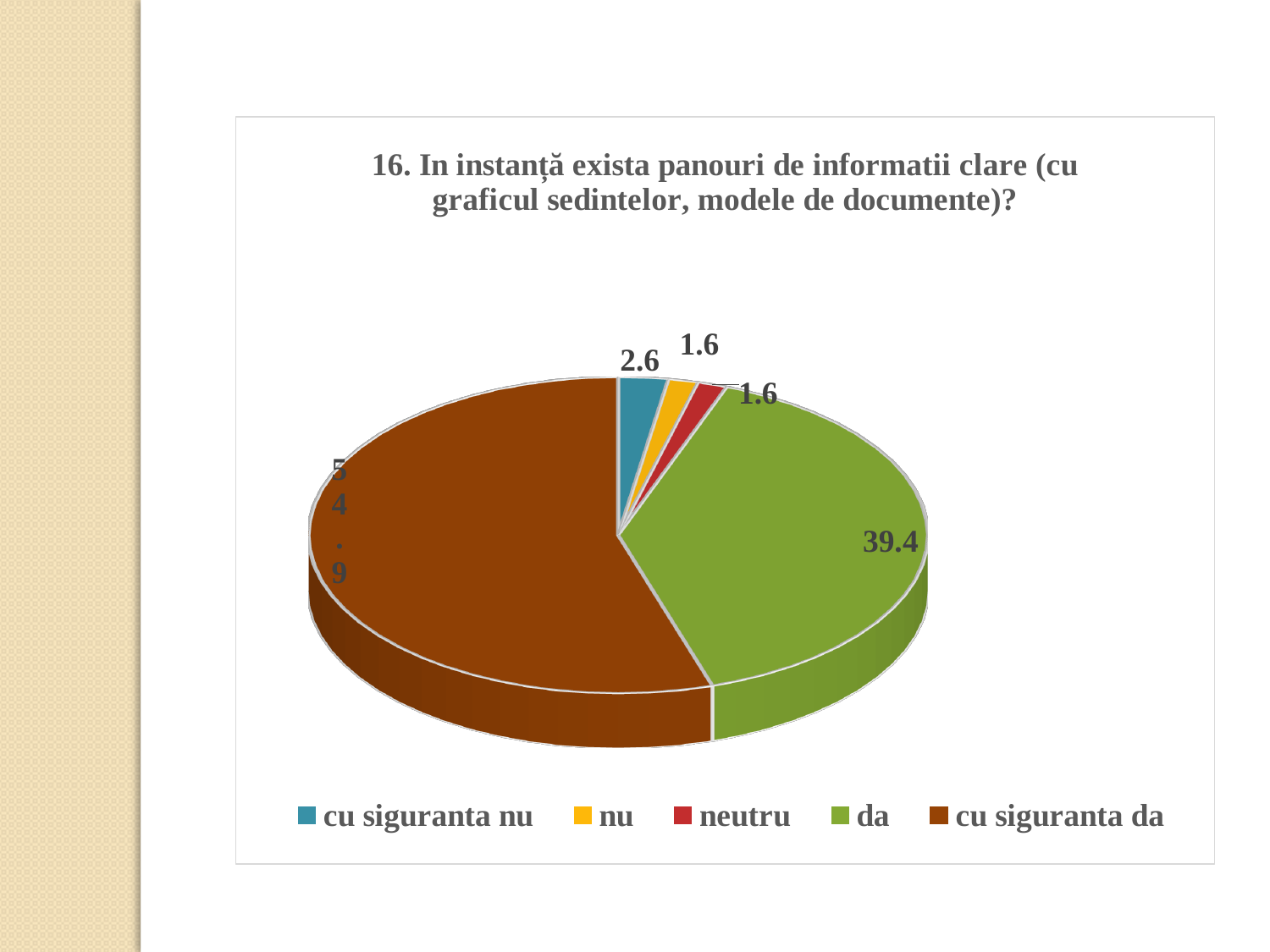
What is the value shown for the "cu siguranta da" slice? 54.9 What colour is the "da" slice in the legend? green What is the value shown for the "cu siguranta nu" slice? 2.6 What is the difference between the values for "cu siguranta da" and "da"? 15.5 What is the value shown for the "da" slice? 39.4 Which is larger, the value for "cu siguranta nu" or the value for "nu"? cu siguranta nu Which is larger, the value for "da" or the value for "cu siguranta da"? cu siguranta da What is the value shown for the "nu" slice? 1.6 Which category has the largest slice of the pie? cu siguranta da What is the value shown for the "neutru" slice? 1.6 What kind of chart is shown on the slide? pie chart How many slices does the pie chart have? 5